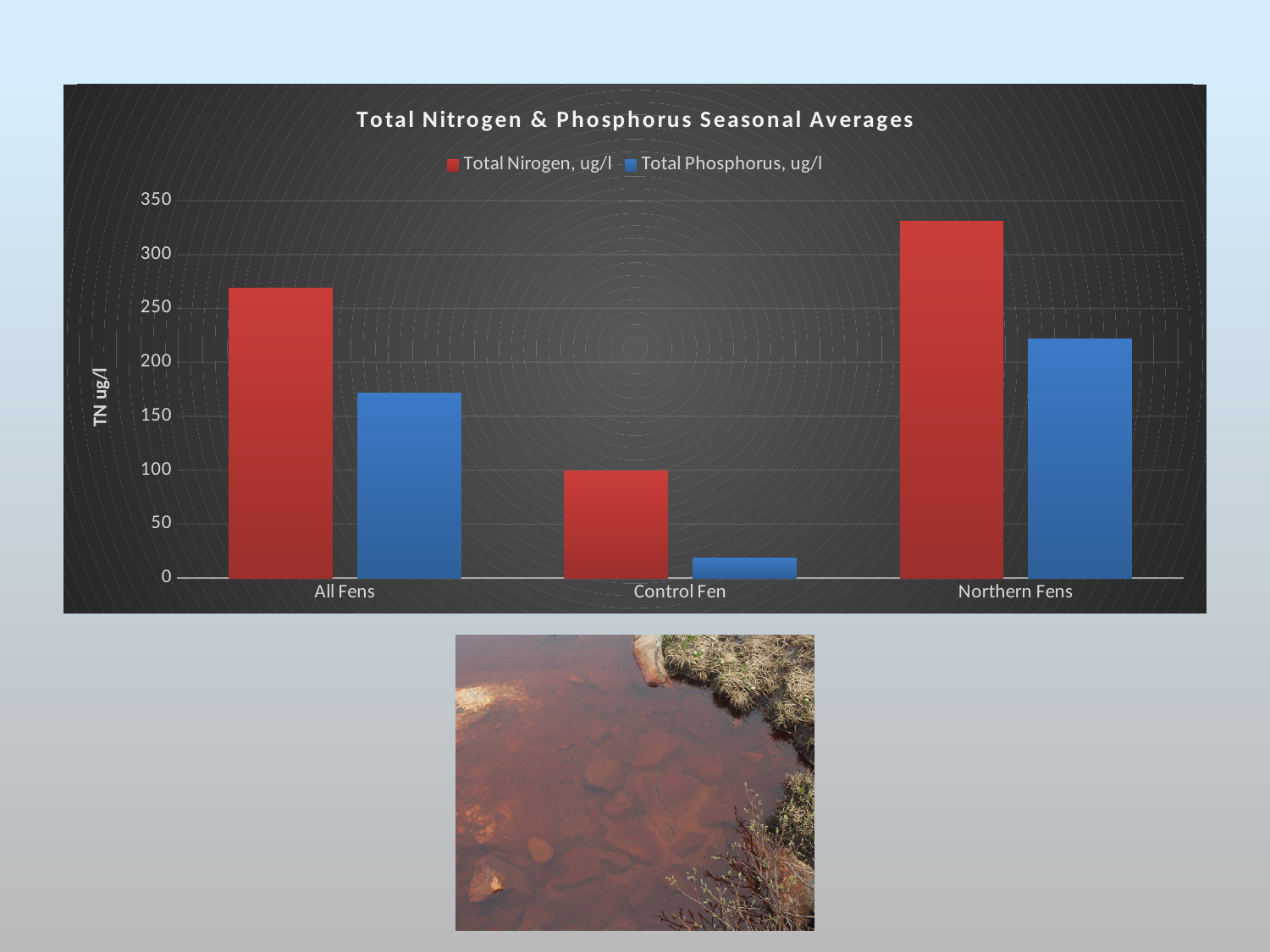
Is the Total Nitrogen value for Northern Fens greater or less than 300? greater How many categories are shown on the x axis? 3 Is the Total Phosphorus value for Control Fen greater or less than 50? less Which category has the highest Total Nitrogen value? Northern Fens What is the title of the chart? Total Nitrogen & Phosphorus Seasonal Averages How many series does the legend list? 2 What is the label on the vertical axis? TN ug/l Is the Total Nitrogen value for All Fens greater or less than 250? greater What type of chart is shown on the slide? Bar chart Which category has the lowest Total Phosphorus value? Control Fen For All Fens, which is larger: Total Nitrogen or Total Phosphorus? Total Nitrogen